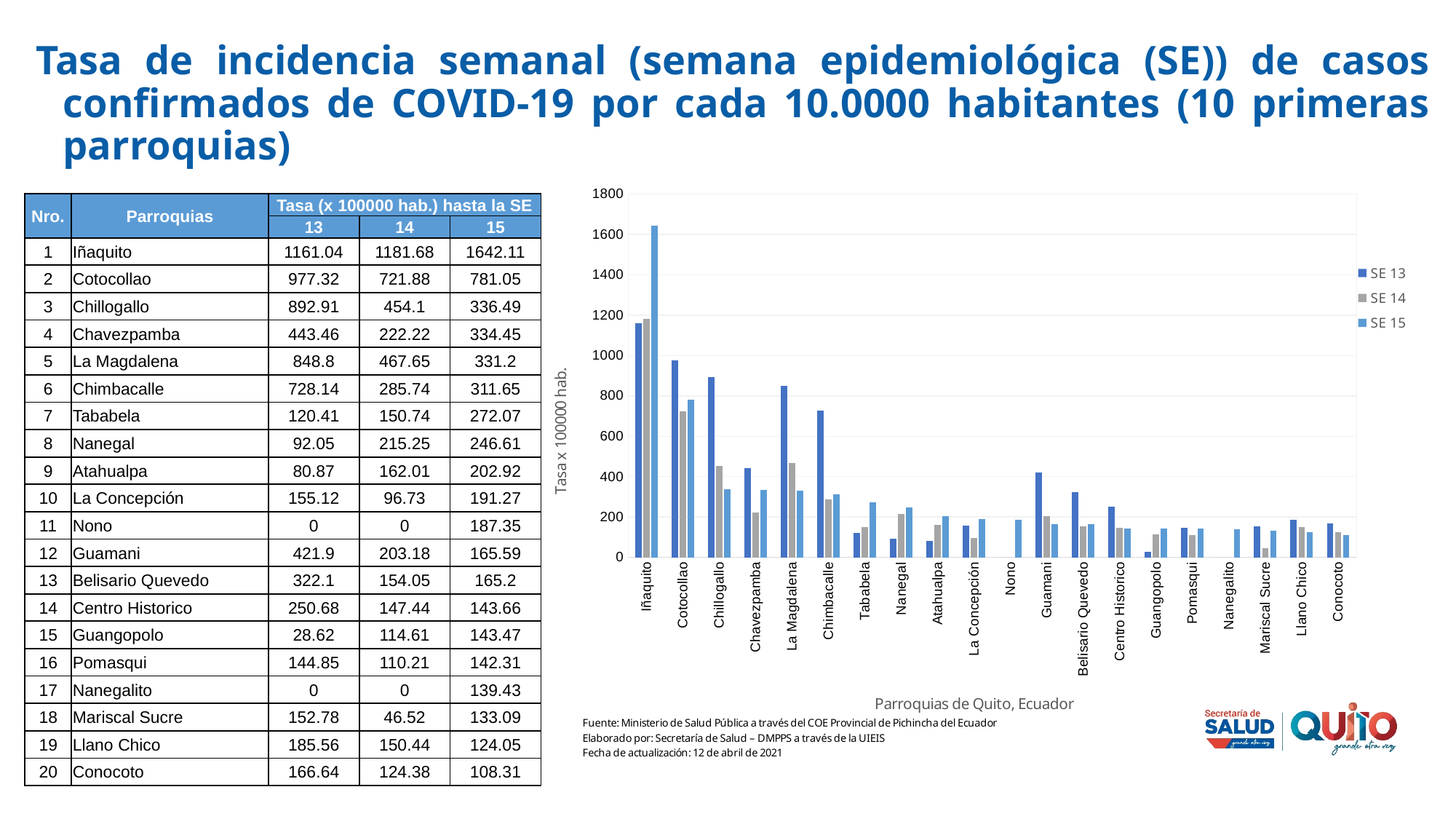
For Chillogallo, which is larger: the SE 13 value or the SE 15 value? SE 13 Which parroquia has the lowest SE 15 value in the chart? Conocoto What kind of chart is shown on the slide? bar chart Do the SE 15 values generally rise or fall moving from left to right along the x axis? fall What is the SE 15 rate for Iñaquito? 1642.11 What is the difference between the SE 15 and SE 14 rates for Iñaquito? 460.43 Is the SE 15 value for Chillogallo greater or less than 400? less Is the SE 13 value for Cotocollao greater or less than 800? greater What is the SE 13 rate for Nono? 0 Which parroquia has the highest SE 15 value in the chart? Iñaquito How many series does the chart legend list? 3 How many parroquias are shown along the x axis of the chart? 20